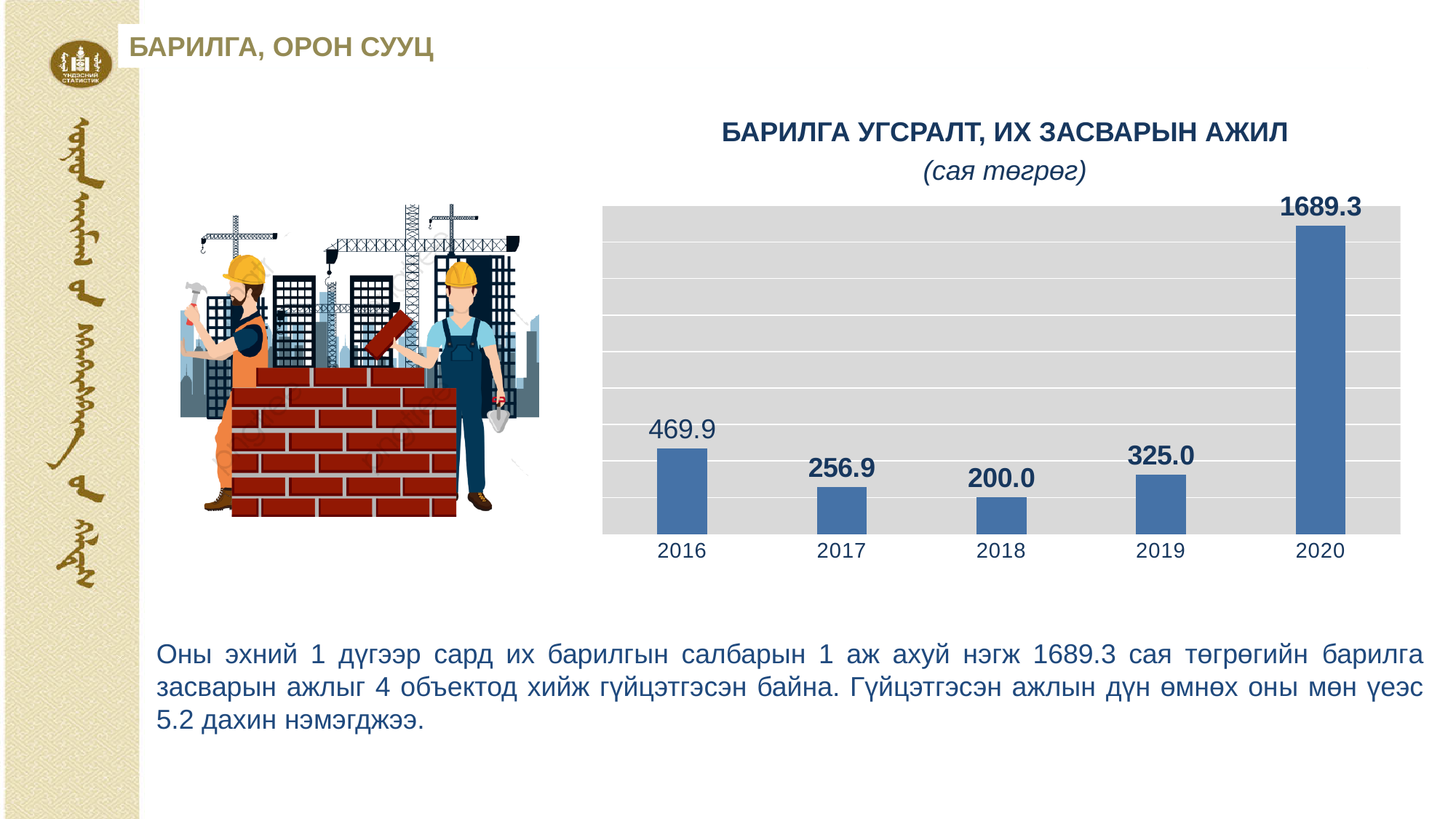
What is the value for 2019? 325.0 Which is larger, the value for 2017 or the value for 2019? 2019 What is the difference between the values for 2016 and 2017? 213.0 What is the value for 2020? 1689.3 What is the value for 2016? 469.9 What unit is given in the chart subtitle? сая төгрөг Which year has the highest value? 2020 Which year has the lowest value? 2018 What is the value for 2018? 200.0 How many years are shown on the chart? 5 What kind of chart is this? bar chart What is the difference between the values for 2020 and 2019? 1364.3